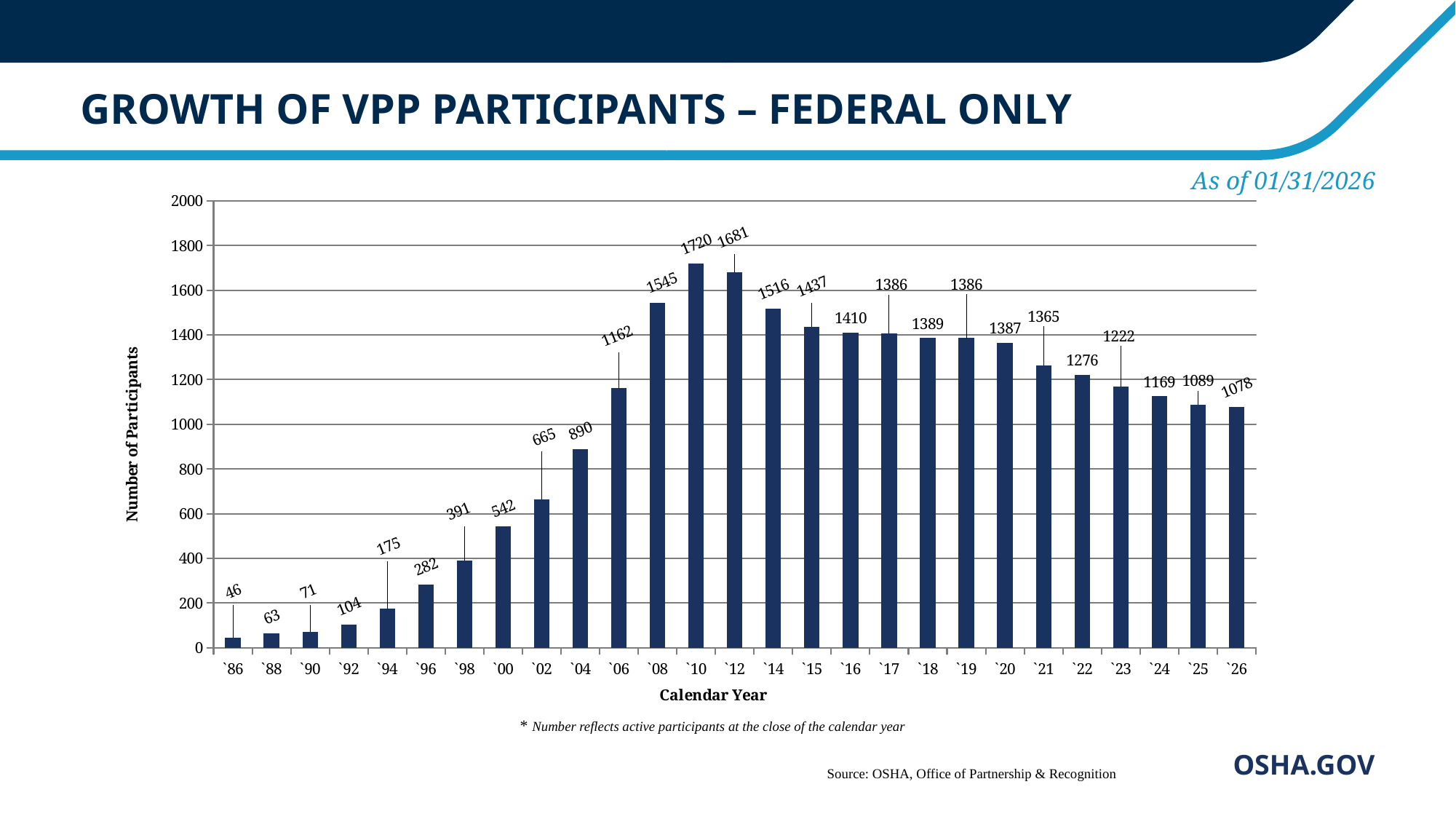
What is the title of the y axis? Number of Participants What kind of chart is shown on the slide? Bar chart Which calendar year has the highest number of participants? `10 What is the difference in participants between `08 and `06? 383 What is the number of participants for `26? 1078 What is the number of participants for `10? 1720 How many calendar years are shown on the x axis? 27 Which has more participants, `04 or `06? `06 Which calendar year has the lowest number of participants? `86 What is the difference in participants between `10 and `12? 39 Do the values rise or fall from `10 to `26? Fall What is the number of participants for `94? 175